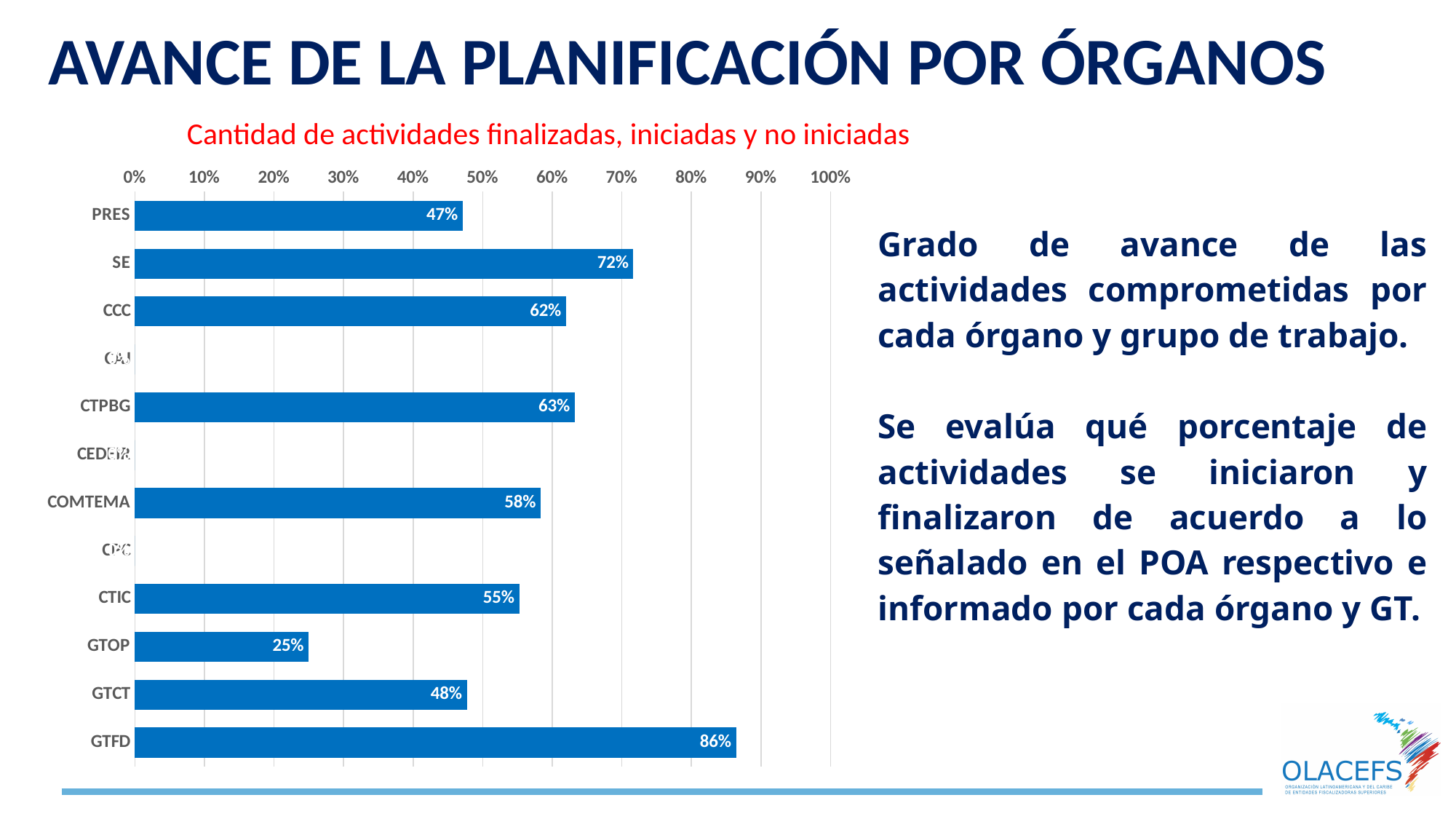
How many bars with data labels are shown in the chart? 9 What is the value for GTOP? 25% What is the value for COMTEMA? 58% What is the difference between the values for GTFD and GTOP? 61% Which category with a plotted bar has the lowest value? GTOP What kind of chart is shown on the slide? Bar chart What is the value for GTFD? 86% Which is larger, the value for CTPBG or the value for CTIC? CTPBG What is the subtitle shown in red above the chart? Cantidad de actividades finalizadas, iniciadas y no iniciadas What is the difference between the values for SE and CCC? 10% Which category has the highest value? GTFD What is the value for SE? 72%